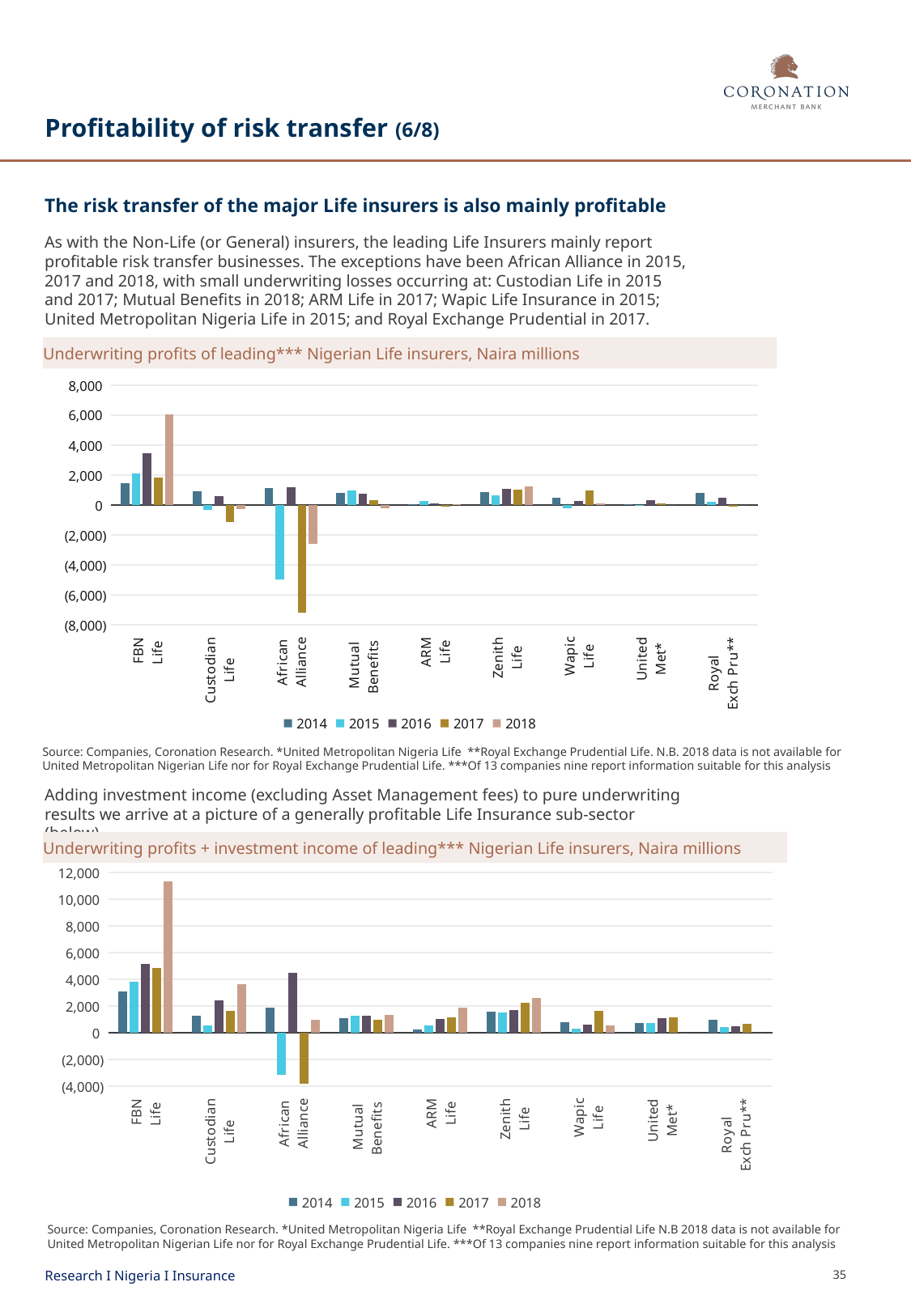
In the bottom chart, 'Underwriting profits + investment income of leading Nigerian Life insurers', is the value for FBN Life in 2018 greater or less than 10,000? greater In the bottom chart, 'Underwriting profits + investment income of leading Nigerian Life insurers', is the value for African Alliance in 2017 greater or less than (2,000)? less In the top chart, 'Underwriting profits of leading Nigerian Life insurers', how many insurers are shown on the x axis? 9 In the top chart, 'Underwriting profits of leading Nigerian Life insurers', how many years does the legend list? 5 What type of chart is the top chart, 'Underwriting profits of leading Nigerian Life insurers'? Bar chart What is the title of the bottom chart? Underwriting profits + investment income of leading*** Nigerian Life insurers, Naira millions In the bottom chart, 'Underwriting profits + investment income of leading Nigerian Life insurers', which insurer has the tallest bar? FBN Life In the top chart, 'Underwriting profits of leading Nigerian Life insurers', which insurer has the tallest positive bar? FBN Life In the top chart, 'Underwriting profits of leading Nigerian Life insurers', is the value for African Alliance in 2017 greater or less than (4,000)? less In the top chart, 'Underwriting profits of leading Nigerian Life insurers', which insurer has the lowest (most negative) bar? African Alliance In the top chart, 'Underwriting profits of leading Nigerian Life insurers', which is larger: the 2018 value for FBN Life or the 2018 value for Zenith Life? FBN Life